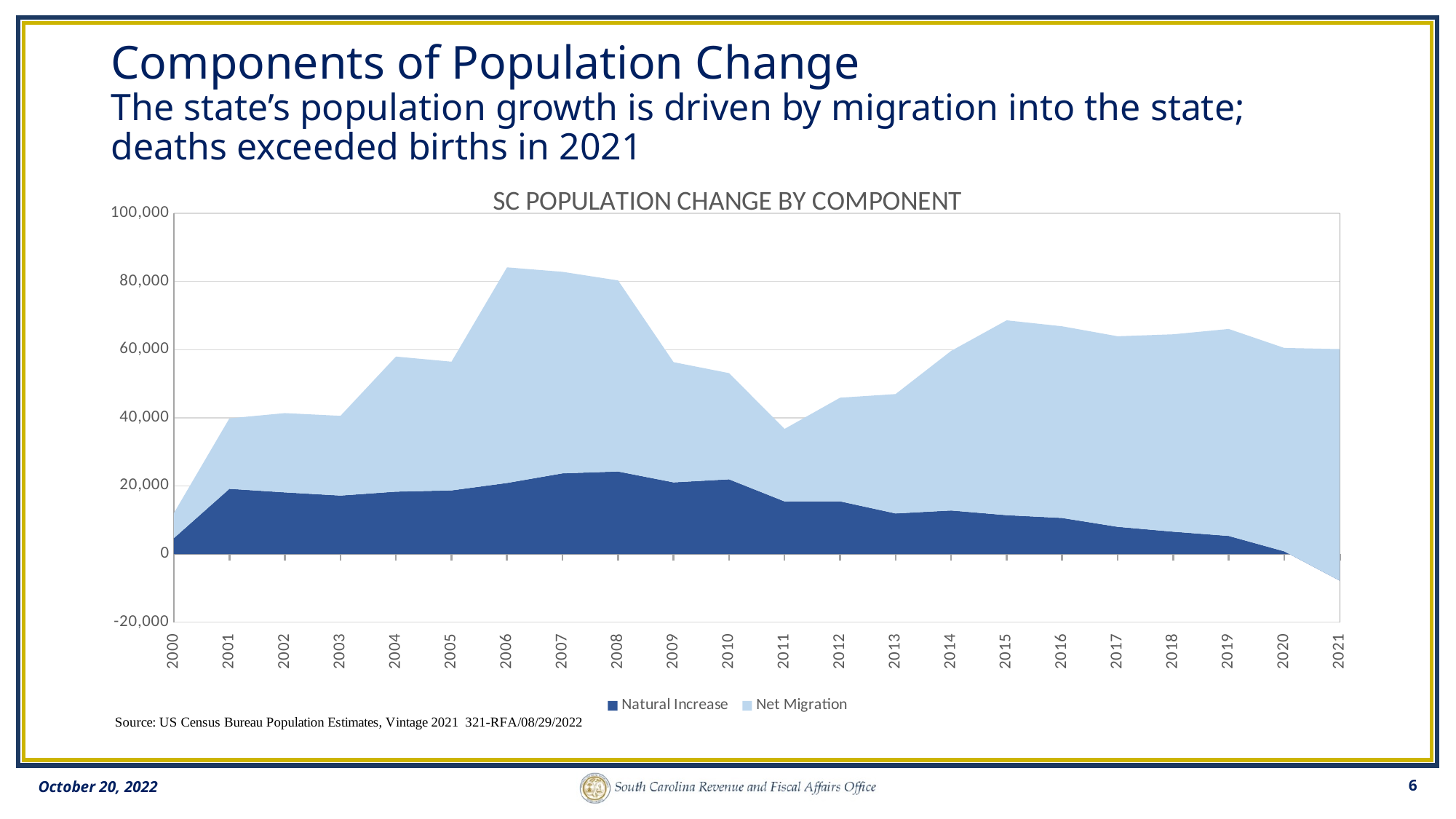
Is the value for Natural Increase in 2008 greater or less than 20,000? greater Is the combined total of Natural Increase and Net Migration in 2006 greater or less than 80,000? greater Which series is shown in dark blue in the chart? Natural Increase Is the combined total of Natural Increase and Net Migration in 2011 greater or less than 40,000? less In which year is the Natural Increase value lowest? 2021 How many series does the chart's legend list? 2 What kind of chart is shown on the slide? Stacked area chart Does the Natural Increase value rise or fall from 2008 to 2021? fall What is the title of the chart? SC POPULATION CHANGE BY COMPONENT In which year is the combined total of Natural Increase and Net Migration lowest? 2000 How many years are plotted along the x axis of the chart? 22